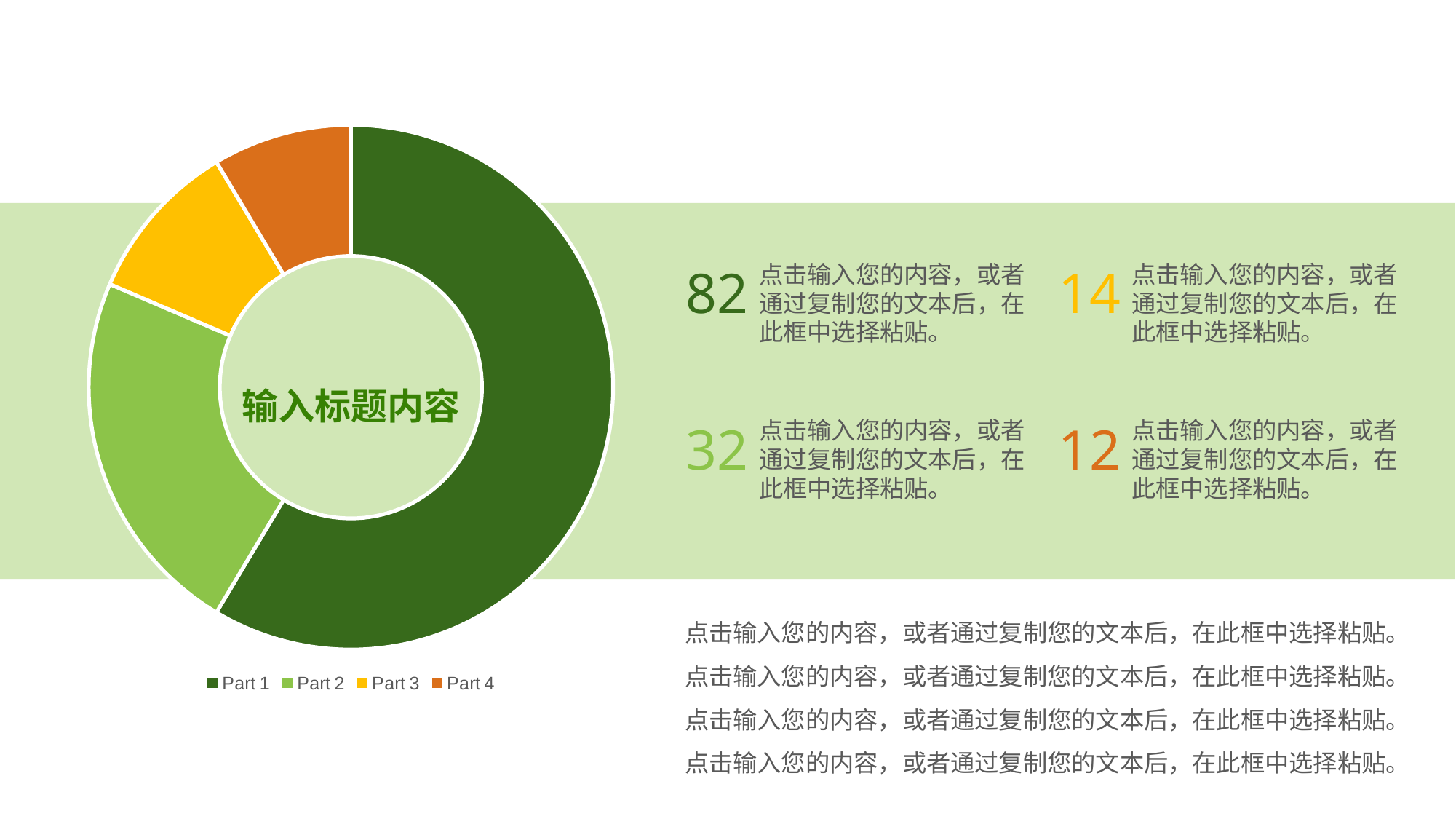
Which is larger in the doughnut chart, Part 2 or Part 3? Part 2 What kind of chart is shown on the slide? Doughnut chart What text is shown in the centre of the doughnut chart? 输入标题内容 Does Part 1 take up more or less than half of the doughnut chart? more Which part takes up the largest share of the doughnut chart? Part 1 Which is larger in the doughnut chart, Part 2 or Part 4? Part 2 How many categories does the doughnut chart have? 4 How many entries does the legend of the doughnut chart list? 4 Which is larger in the doughnut chart, Part 1 or Part 2? Part 1 What colour is the Part 1 slice in the doughnut chart? Dark green